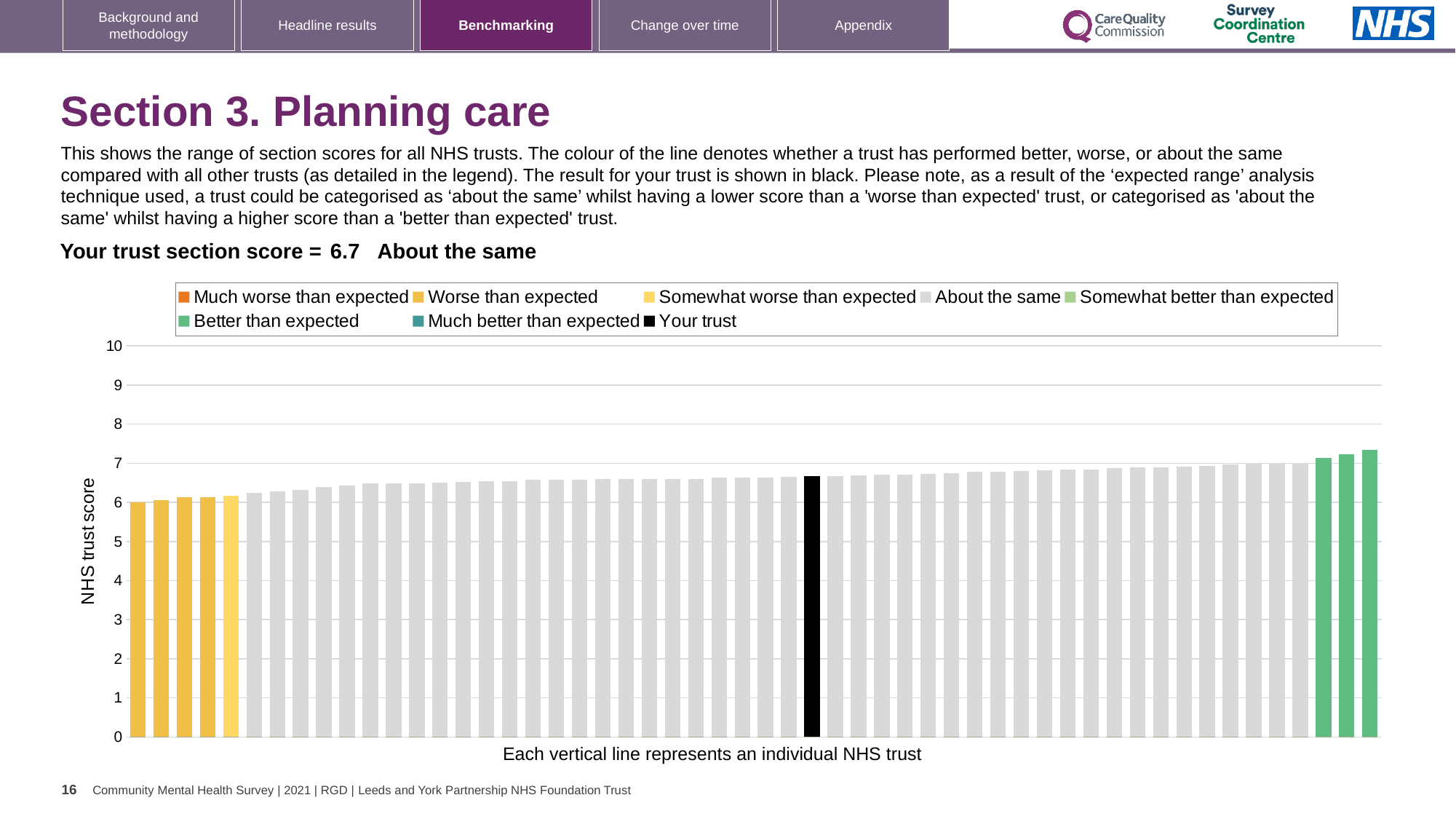
Is the value of the black bar (your trust) greater or less than 6? greater Is the value of the rightmost (highest) bar greater or less than 7? greater Is the value of the black bar (your trust) greater or less than 7? less Do the bar values rise or fall moving from left to right along the x axis? rise How many bars are coloured green (Better than expected)? 3 How many entries does the chart legend list? 8 What is the section score for your trust shown on the slide? 6.7 What kind of chart is shown on the slide? bar chart Which benchmarking category is your trust placed in for Section 3. Planning care? About the same What is the label on the vertical axis of the chart? NHS trust score What colour is the bar representing your trust? black